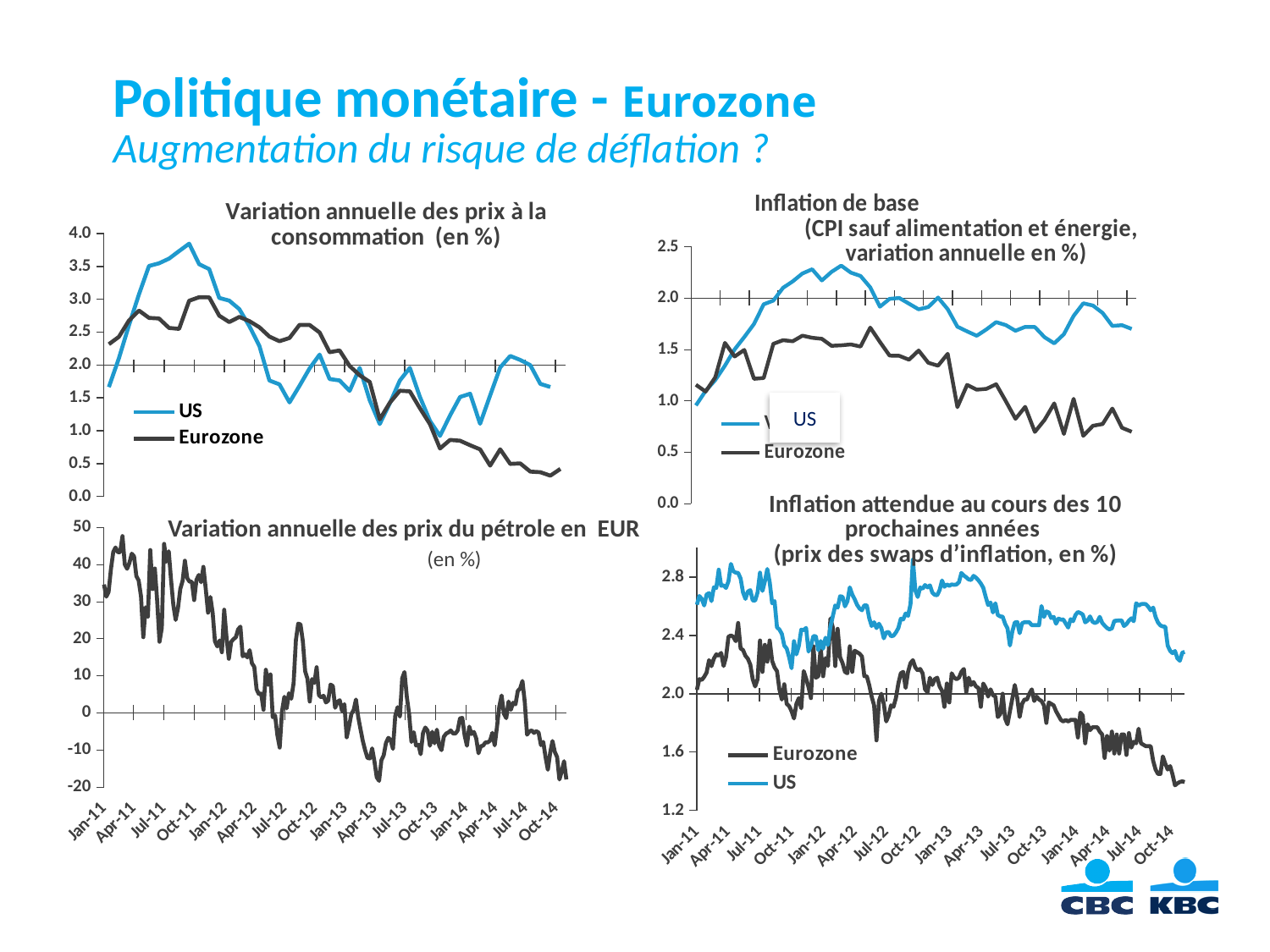
In the top-left chart 'Variation annuelle des prix à la consommation', is the Eurozone value at Oct-14 greater or less than 1.0? less In the bottom-right chart 'Inflation attendue au cours des 10 prochaines années', how many series does the legend list? 2 In the bottom-left chart 'Variation annuelle des prix du pétrole en EUR', does the line overall rise or fall from Jan-11 to Oct-14? fall How many series are plotted in the bottom-left chart 'Variation annuelle des prix du pétrole en EUR'? 1 What type of chart is the top-left chart titled 'Variation annuelle des prix à la consommation (en %)'? Line chart In the top-right chart 'Inflation de base', which series is higher at Oct-14, US or Eurozone? US In the top-left chart 'Variation annuelle des prix à la consommation', does the Eurozone line rise or fall from Jan-12 to Oct-14? fall In the top-right chart 'Inflation de base', is the Eurozone value at Oct-14 greater or less than 1.0? less In the bottom-right chart 'Inflation attendue au cours des 10 prochaines années', is the Eurozone value at Oct-14 greater or less than 1.6? less In the top-left chart 'Variation annuelle des prix à la consommation', how many series does the legend list? 2 How many charts are shown on the slide? 4